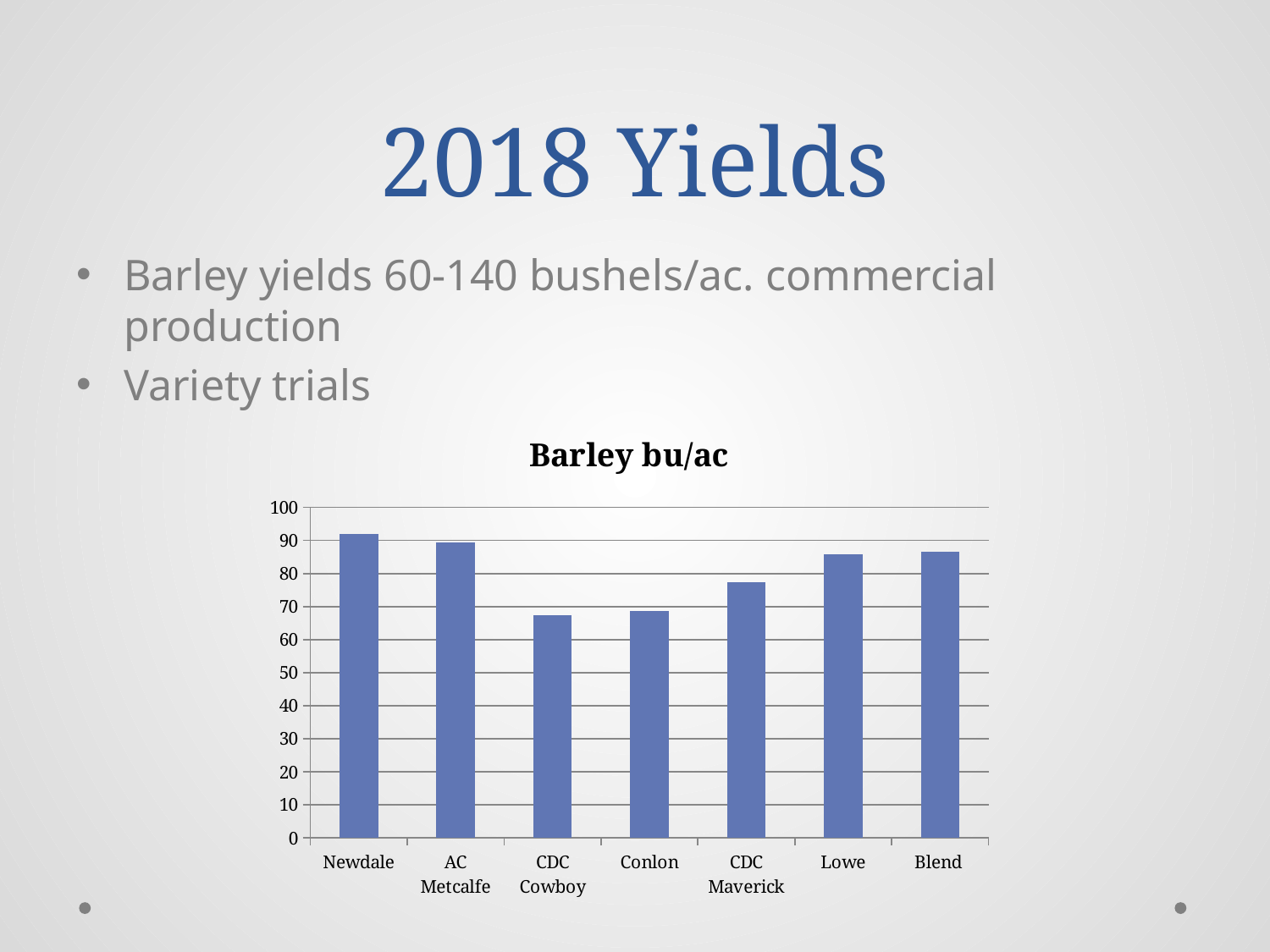
Which is larger, the value for Newdale or the value for CDC Cowboy? Newdale Which variety has the highest yield in the chart? Newdale Which is larger, the value for CDC Maverick or the value for AC Metcalfe? AC Metcalfe Is the value for CDC Cowboy greater or less than 70? less Is the value for Newdale greater or less than 90? greater Is the value for CDC Maverick greater or less than 80? less Do the values rise or fall from Newdale to CDC Cowboy? fall How many barley varieties are plotted in the chart? 7 What type of chart is shown on the slide? bar chart What is the title of the chart? Barley bu/ac